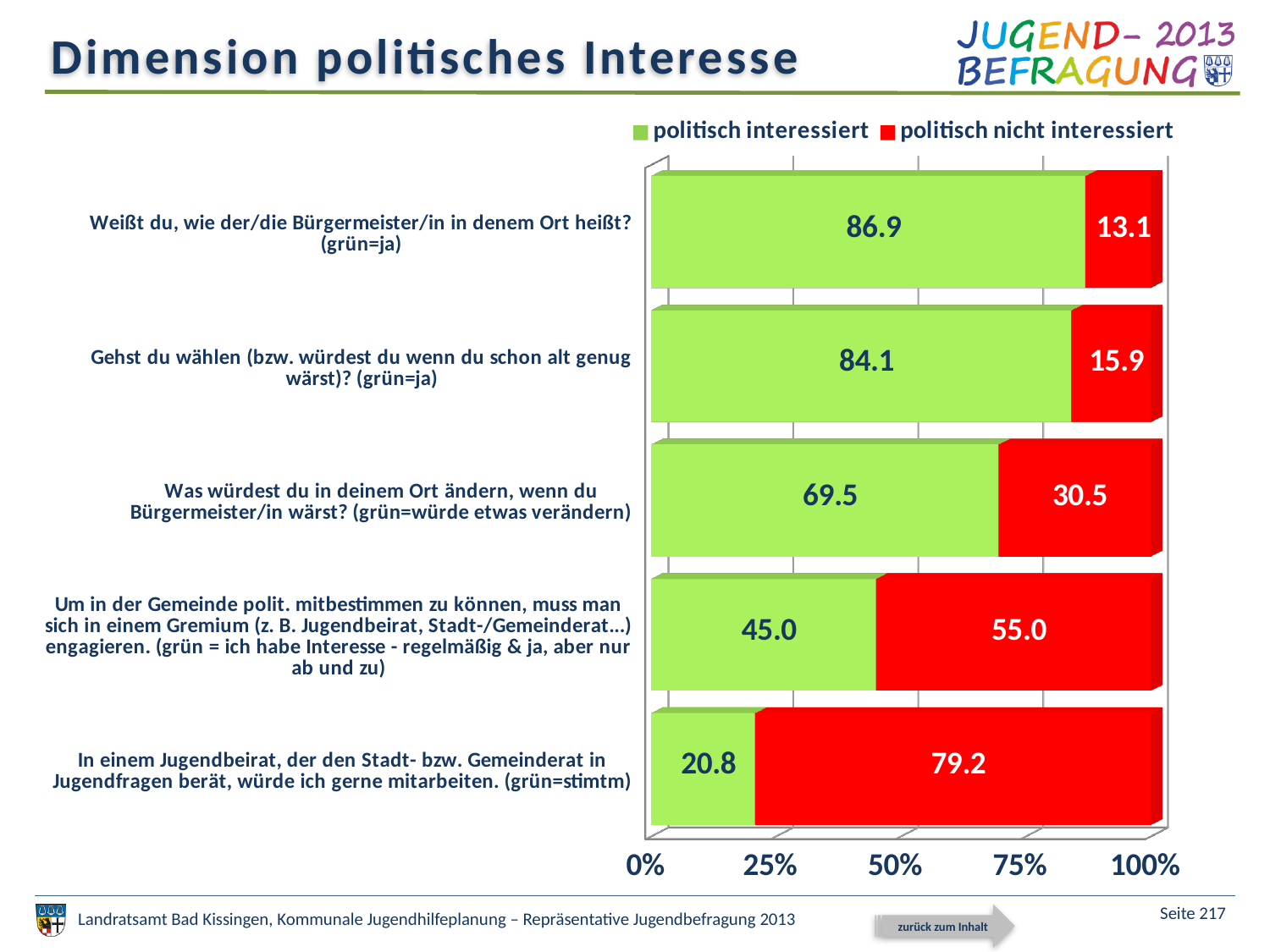
What is the value for "politisch interessiert" for "In einem Jugendbeirat, der den Stadt- bzw. Gemeinderat in Jugendfragen berät, würde ich gerne mitarbeiten."? 20.8 How many categories (questions) are shown in the chart? 5 Which category has the highest value for "politisch nicht interessiert"? In einem Jugendbeirat, der den Stadt- bzw. Gemeinderat in Jugendfragen berät, würde ich gerne mitarbeiten. What is the total of the stacked bar for "Was würdest du in deinem Ort ändern, wenn du Bürgermeister/in wärst?"? 100.0 What is the value for "politisch interessiert" for "Weißt du, wie der/die Bürgermeister/in in denem Ort heißt?"? 86.9 What is the value for "politisch nicht interessiert" for "Gehst du wählen (bzw. würdest du wenn du schon alt genug wärst)?"? 15.9 How many series does the legend list? 2 For "Um in der Gemeinde polit. mitbestimmen zu können, muss man sich in einem Gremium engagieren", which is larger: "politisch interessiert" or "politisch nicht interessiert"? politisch nicht interessiert Which category has the lowest value for "politisch interessiert"? In einem Jugendbeirat, der den Stadt- bzw. Gemeinderat in Jugendfragen berät, würde ich gerne mitarbeiten. Which colour represents "politisch nicht interessiert" in the chart? Red What type of chart is shown on the slide? Stacked bar chart What is the difference between the "politisch interessiert" values for "Weißt du, wie der/die Bürgermeister/in in denem Ort heißt?" and "Gehst du wählen"? 2.8